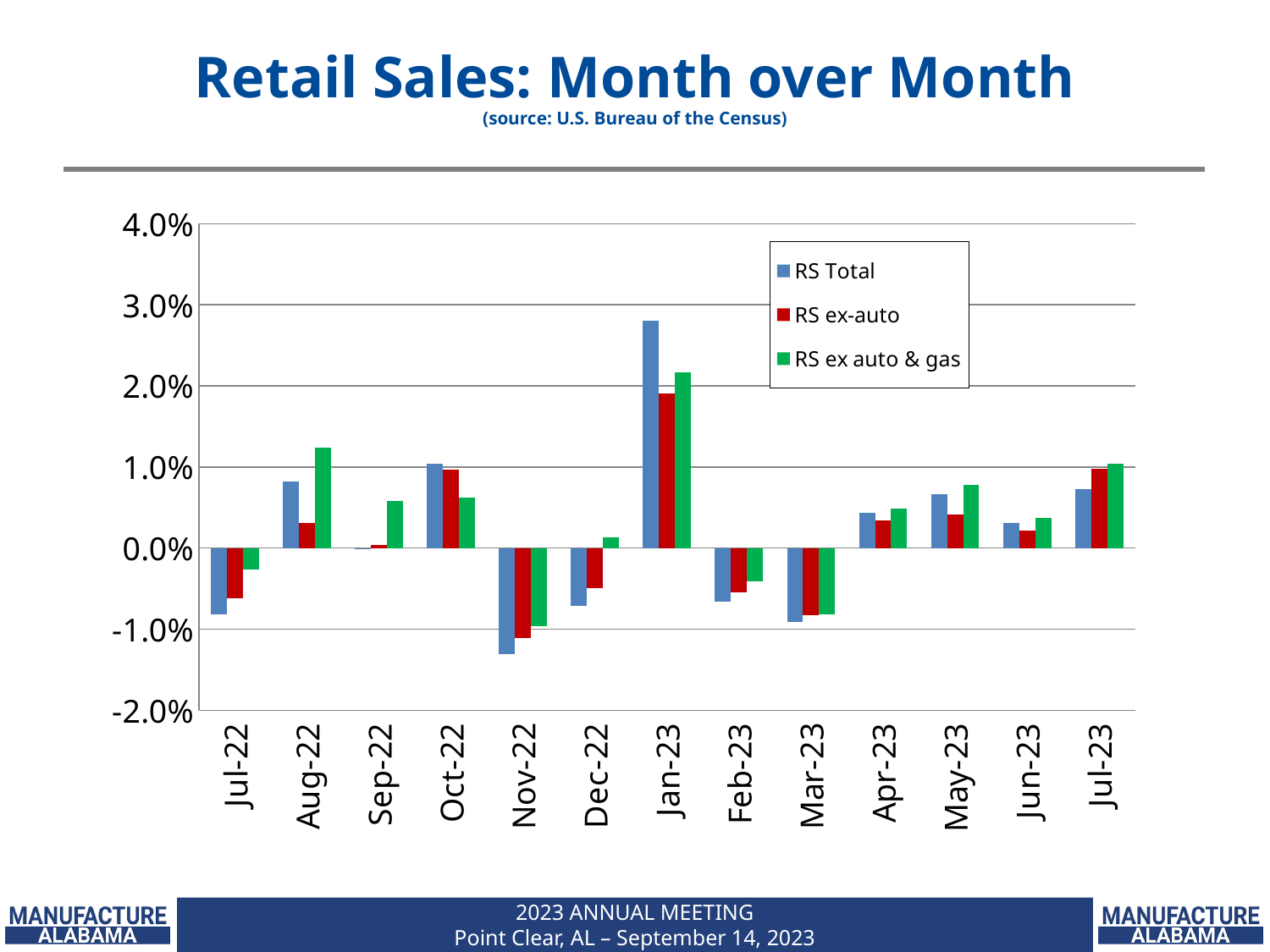
What are the three series listed in the legend? RS Total, RS ex-auto, RS ex auto & gas For Aug-22, which is larger: RS Total or RS ex auto & gas? RS ex auto & gas What kind of chart is shown on the slide? Bar chart For Jan-23, which is larger: RS Total or RS ex-auto? RS Total Is the RS Total value for Nov-22 greater or less than -1.0%? less How many series does the legend list? 3 In which month is the RS ex auto & gas value highest? Jan-23 Is the RS ex auto & gas value for Aug-22 greater or less than 1.0%? greater How many months are shown on the x axis? 13 Is the RS Total value for Jan-23 greater or less than 2.0%? greater In which month is the RS Total value lowest? Nov-22 In which month is the RS Total value highest? Jan-23